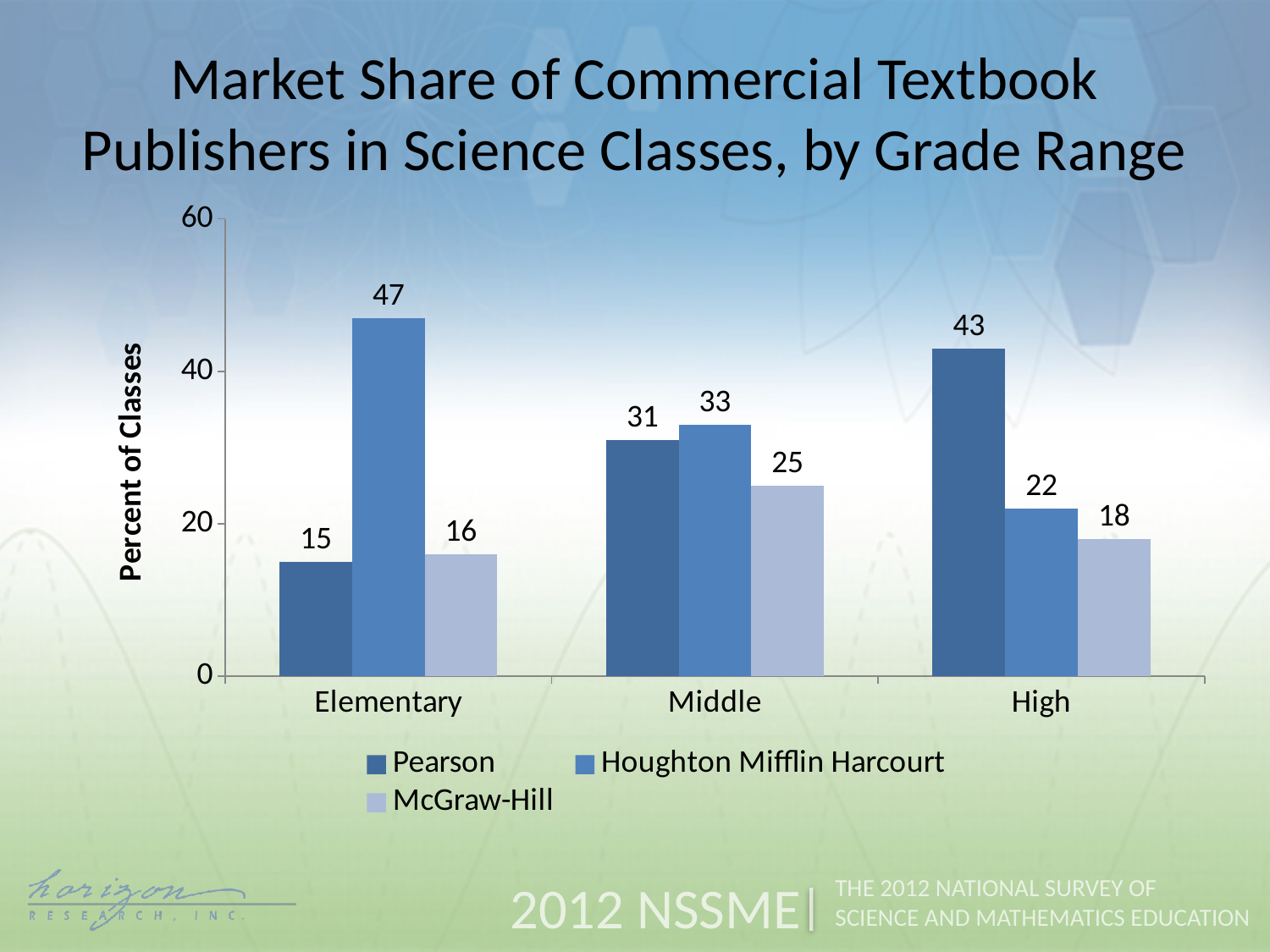
What kind of chart is shown on the slide? bar chart Is the value for Pearson in the High grade range greater or less than 40? greater What is the value for Houghton Mifflin Harcourt in the Middle grade range? 33 What is the value for McGraw-Hill in the High grade range? 18 What is the difference between the Houghton Mifflin Harcourt value and the Pearson value in the Elementary grade range? 32 Which publisher has the highest value in the Elementary grade range? Houghton Mifflin Harcourt Do the Pearson values rise or fall from Elementary to High? rise How many grade ranges are shown on the x axis? 3 Which is larger in the Middle grade range: the Pearson value or the McGraw-Hill value? Pearson How many series does the legend list? 3 Which publisher has the lowest value in the High grade range? McGraw-Hill What is the value for Pearson in the Elementary grade range? 15